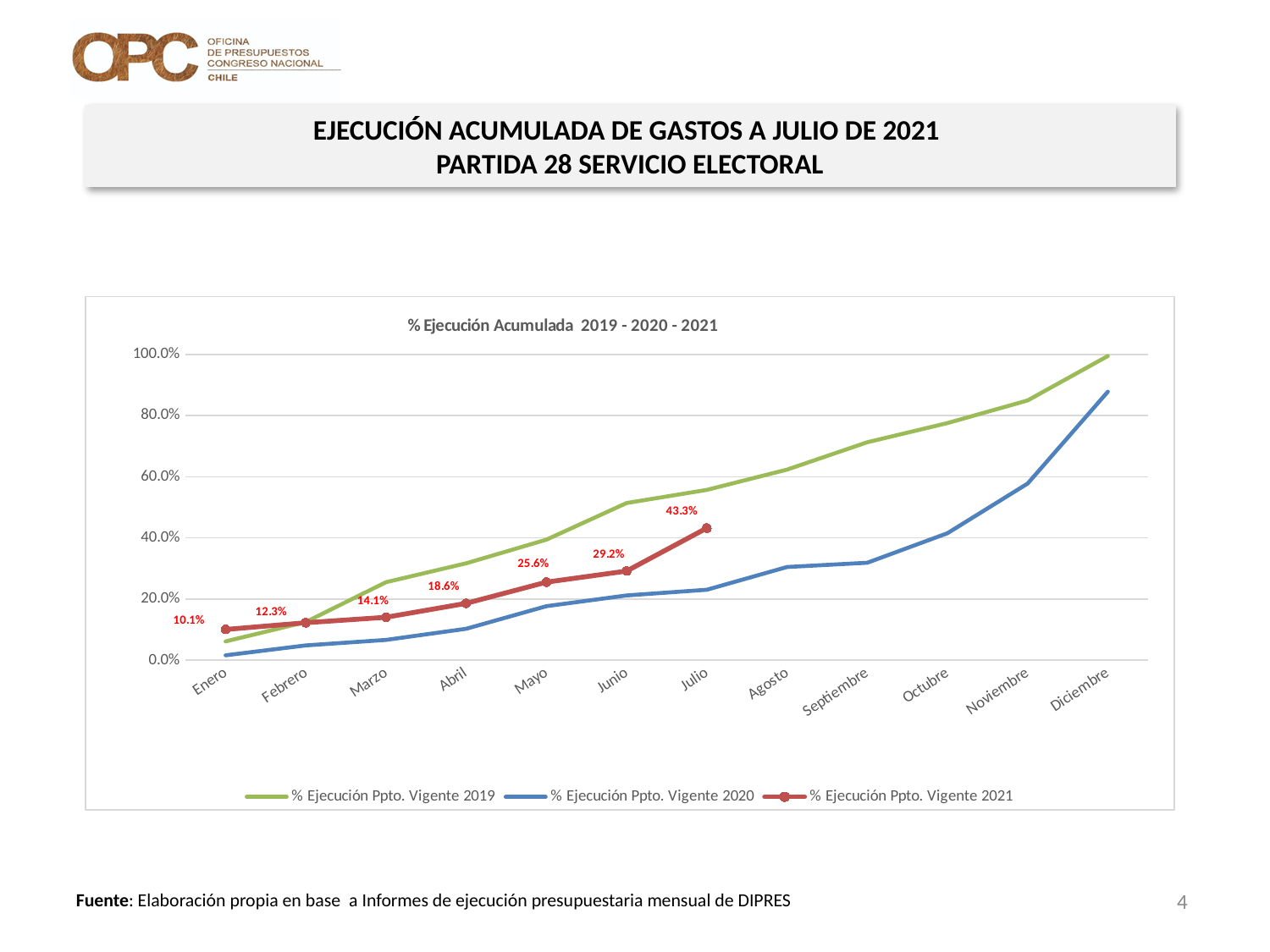
What is the value of % Ejecución Ppto. Vigente 2021 for Julio? 43.3% By how many percentage points did % Ejecución Ppto. Vigente 2021 increase from Junio to Julio? 14.1 percentage points Does the % Ejecución Ppto. Vigente 2021 series rise or fall from Enero to Julio? Rise In Diciembre, which series is higher: % Ejecución Ppto. Vigente 2019 or % Ejecución Ppto. Vigente 2020? % Ejecución Ppto. Vigente 2019 In which month does the % Ejecución Ppto. Vigente 2021 series reach its highest labelled value? Julio How many months are shown on the x axis of the chart? 12 What is the value of % Ejecución Ppto. Vigente 2021 for Abril? 18.6% Is the value for % Ejecución Ppto. Vigente 2020 in Diciembre greater or less than 80.0%? greater What is the value of % Ejecución Ppto. Vigente 2021 for Enero? 10.1% What type of chart is shown on the slide? Line chart What is the title of the chart? % Ejecución Acumulada 2019 - 2020 - 2021 How many series does the chart legend list? 3